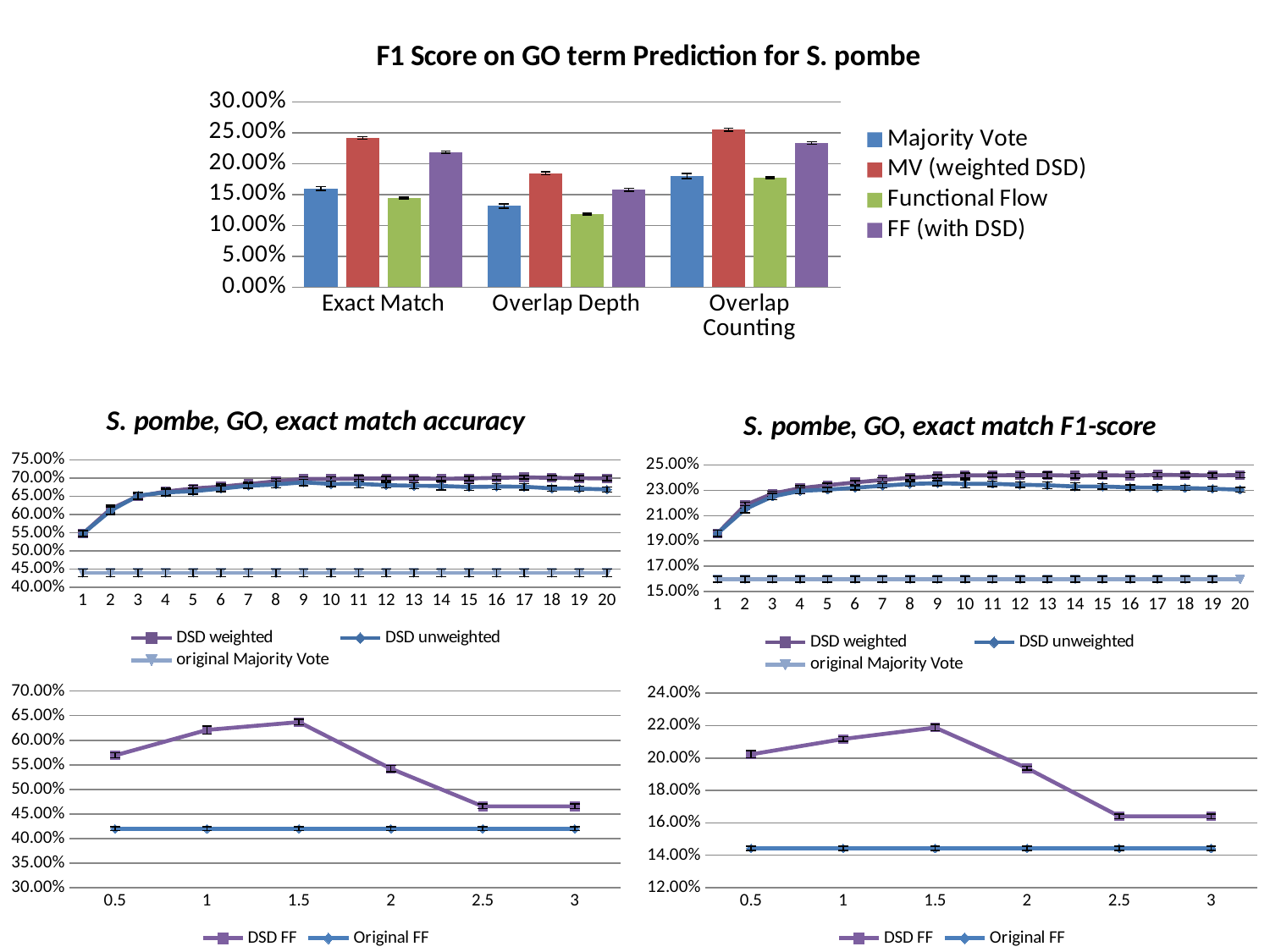
In the bottom-right chart (DSD FF vs Original FF), is the DSD FF value at x = 1.5 greater or less than 20.00%? greater In the top chart 'F1 Score on GO term Prediction for S. pombe', which series has the highest value for Exact Match? MV (weighted DSD) In the top chart 'F1 Score on GO term Prediction for S. pombe', which series has the lowest value for Overlap Depth? Functional Flow In the top chart 'F1 Score on GO term Prediction for S. pombe', is the MV (weighted DSD) value for Overlap Counting greater or less than 20.00%? greater In the chart 'S. pombe, GO, exact match accuracy', does the DSD weighted line rise or fall from x = 1 to x = 20? rise In the top chart 'F1 Score on GO term Prediction for S. pombe', how many categories are shown on the x axis? 3 In the top chart 'F1 Score on GO term Prediction for S. pombe', is the Majority Vote value for Exact Match greater or less than 20.00%? less What kind of chart is the top chart titled 'F1 Score on GO term Prediction for S. pombe'? bar chart In the top chart 'F1 Score on GO term Prediction for S. pombe', how many series does the legend list? 4 In the bottom-left chart (DSD FF vs Original FF), at which x value does the DSD FF line reach its highest point? 1.5 In the chart 'S. pombe, GO, exact match accuracy', how many series does the legend list? 3